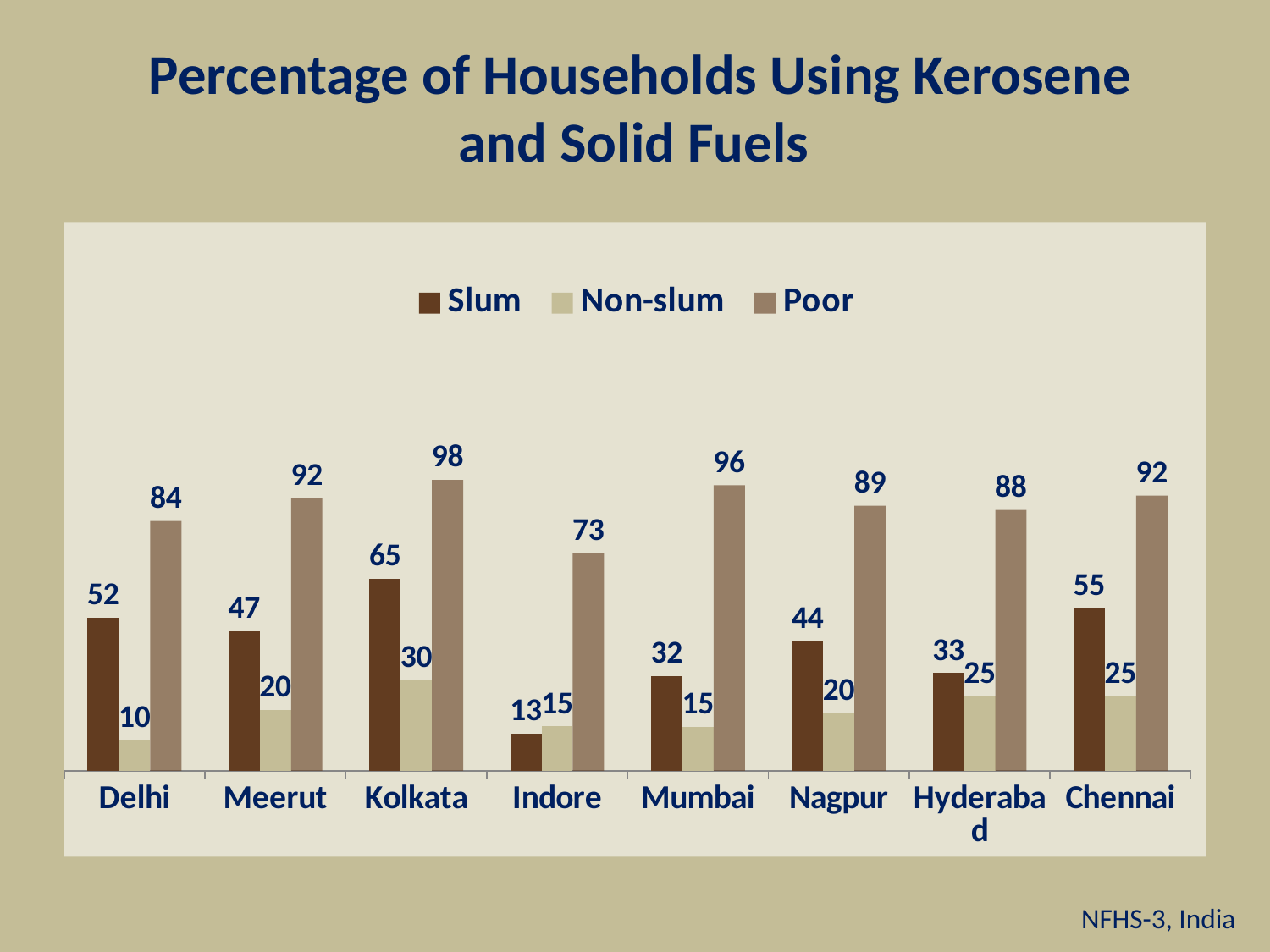
Which city has the highest Poor value? Kolkata What is the Non-slum value for Hyderabad? 25 What kind of chart is shown? Bar chart How many cities are shown on the x axis? 8 What is the difference between the Poor and Slum values for Mumbai? 64 What is the title of the chart? Percentage of Households Using Kerosene and Solid Fuels Which is larger, the Slum value for Delhi or the Slum value for Chennai? Chennai How many series does the legend list? 3 Which city has the lowest Slum value? Indore What is the Poor value for Indore? 73 What is the Slum value for Kolkata? 65 What is the difference between the Non-slum values for Kolkata and Delhi? 20